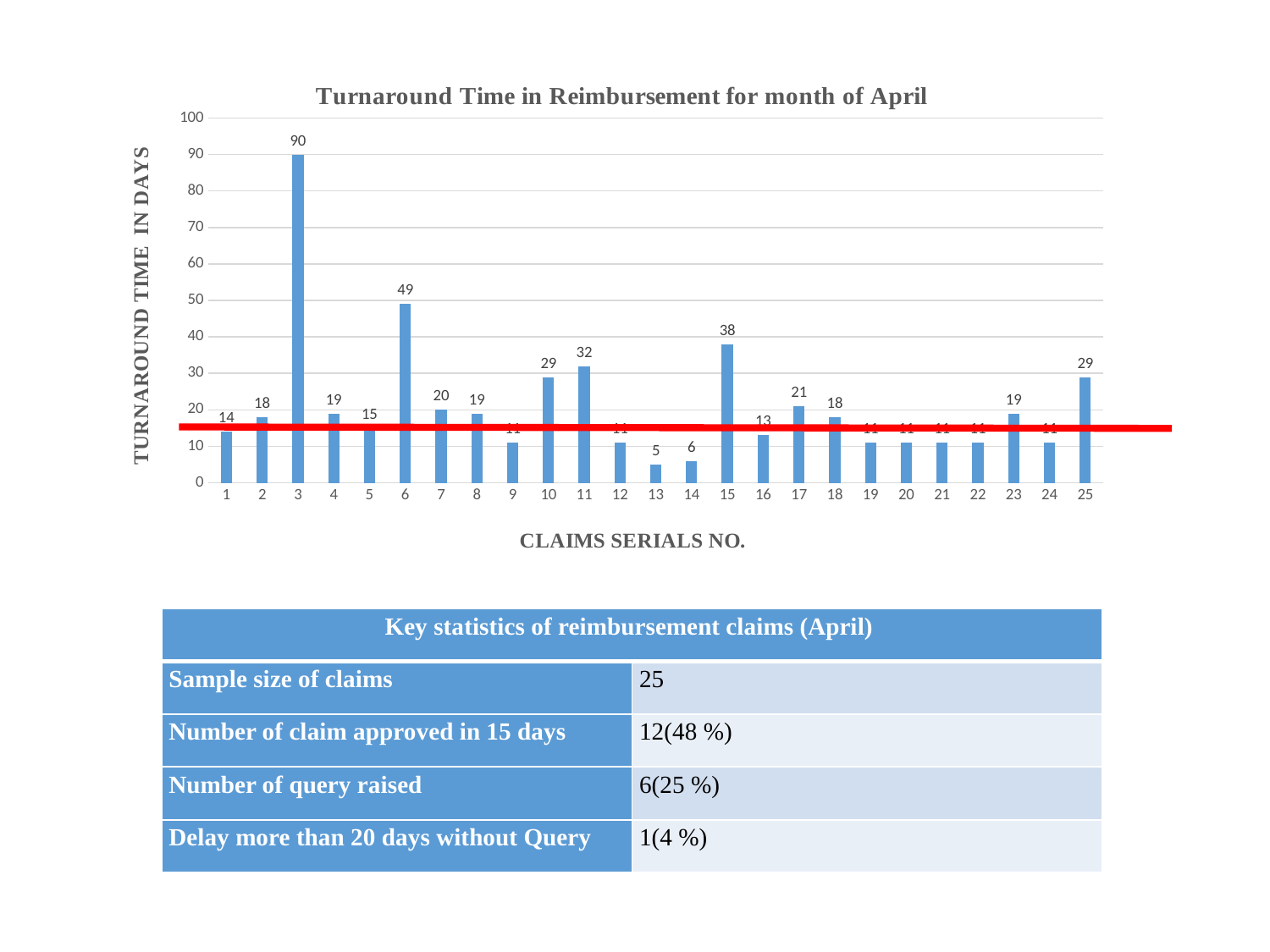
Is the turnaround time for claim serial no. 25 greater or less than 20 days? greater Which has a larger turnaround time, claim serial no. 10 or claim serial no. 11? claim serial no. 11 Which claim serial no. has the lowest turnaround time? 13 What is the turnaround time in days for claim serial no. 6? 49 What is the turnaround time in days for claim serial no. 3? 90 What is the title of the chart? Turnaround Time in Reimbursement for month of April What kind of chart is shown on the slide? bar chart What is the label of the y axis? TURNAROUND TIME IN DAYS What is the turnaround time in days for claim serial no. 15? 38 Which claim serial no. has the highest turnaround time? 3 What is the difference in turnaround time between claim serial no. 3 and claim serial no. 6? 41 How many claim serial numbers are plotted on the x axis? 25